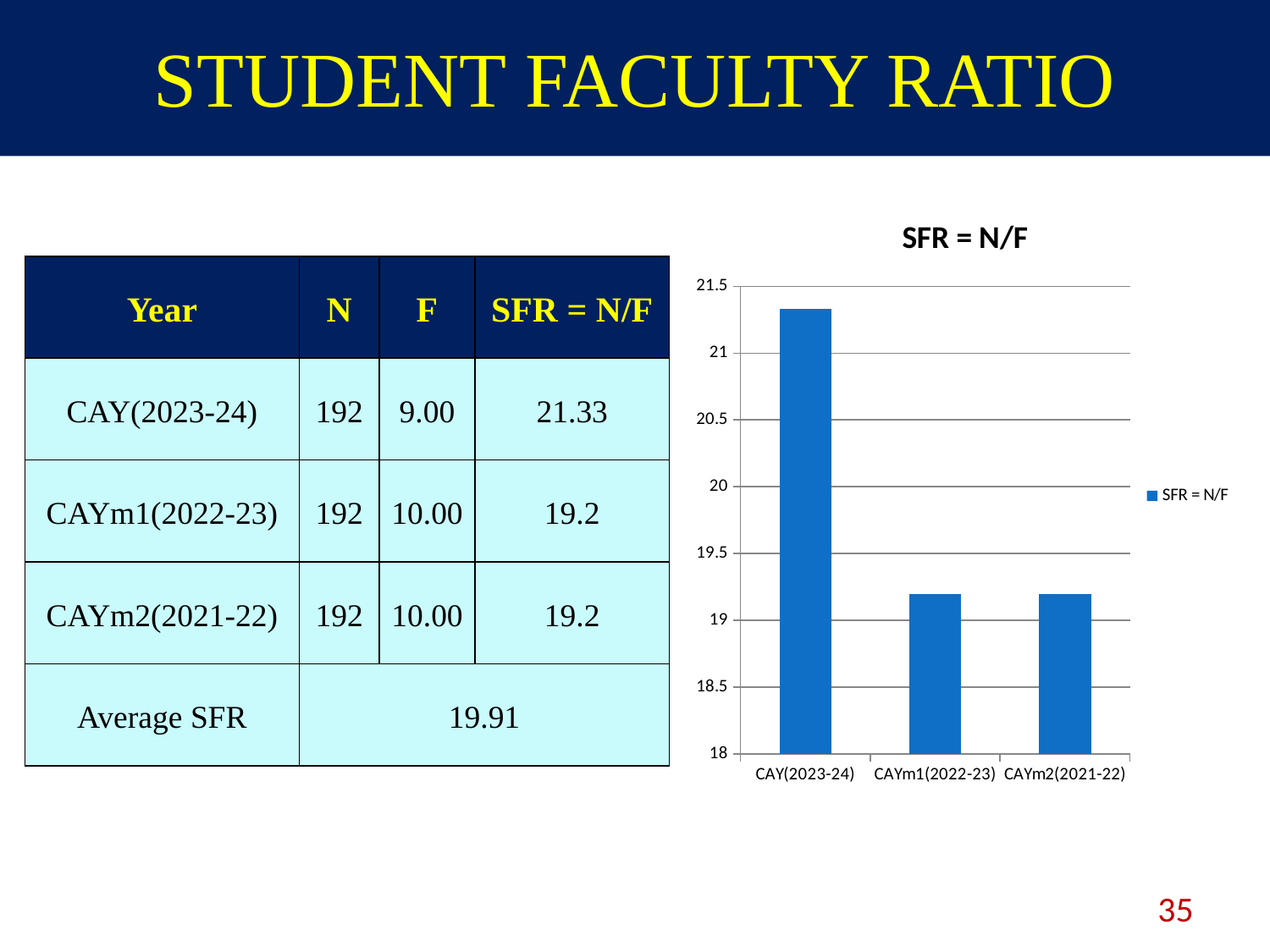
What kind of chart is shown on the slide? bar chart What is the SFR value for CAY(2023-24)? 21.33 Which year has the highest SFR bar in the chart? CAY(2023-24) What is the SFR value for CAYm2(2021-22)? 19.2 What is the difference between the SFR for CAY(2023-24) and the SFR for CAYm1(2022-23)? 2.13 Is the SFR value for CAYm1(2022-23) greater or less than 19.5? less Which is larger in the chart, the SFR for CAY(2023-24) or for CAYm1(2022-23)? CAY(2023-24) What is the title of the chart? SFR = N/F Is the SFR value for CAY(2023-24) greater or less than 21? greater How many categories are plotted on the x axis of the chart? 3 Is the SFR value for CAYm2(2021-22) greater or less than 19? greater How many series does the chart legend list? 1